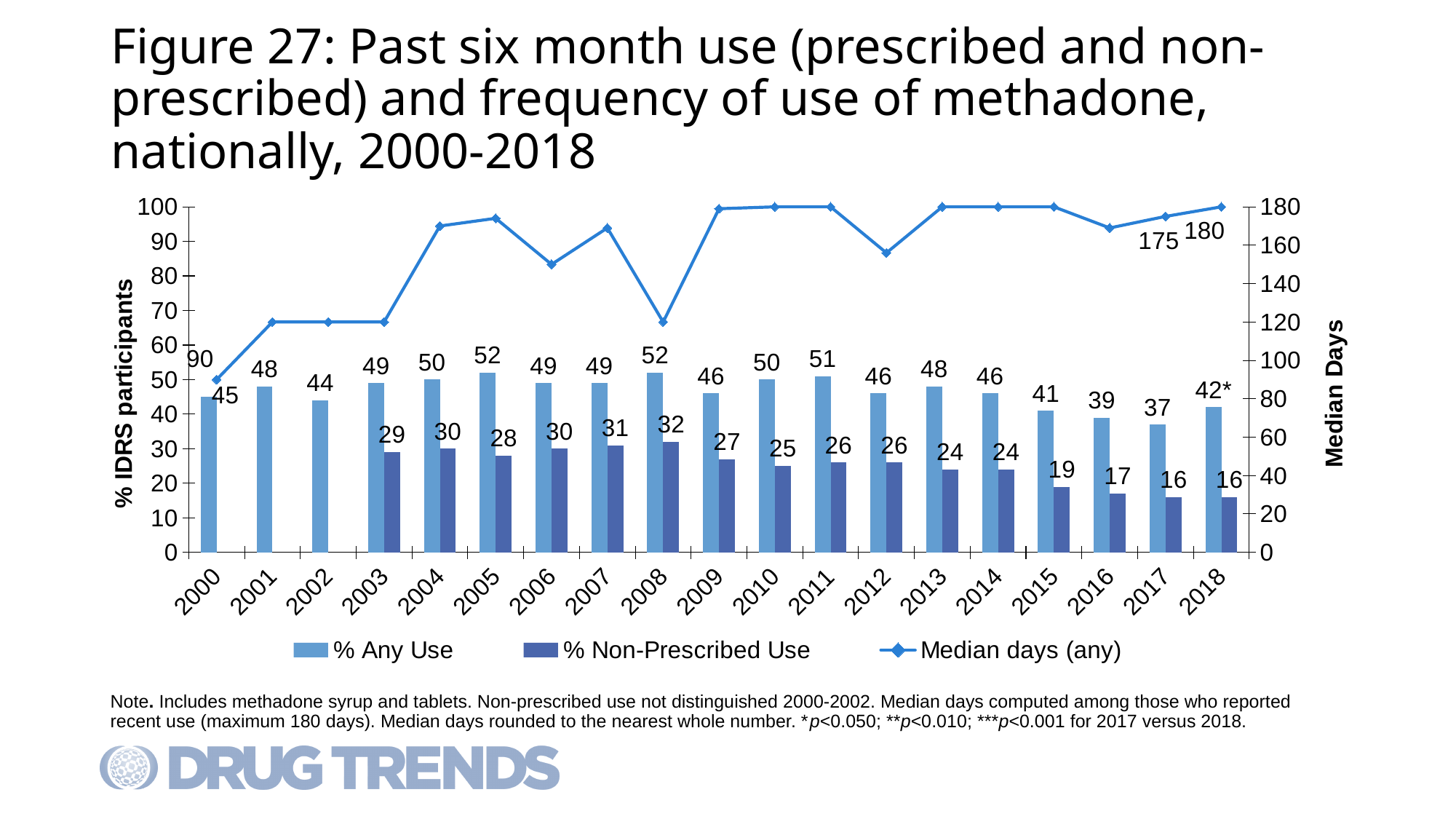
What kind of chart is this? Combined bar and line chart What is the % Any Use value for 2005? 52 What is the % Non-Prescribed Use value for 2008? 32 What is the Median days (any) value labelled for 2017? 175 Does % Non-Prescribed Use rise or fall from 2013 to 2018? fall Is the Median days (any) value for 2008 greater or less than 140? less In which year is % Any Use lowest? 2017 How many years are shown on the x axis? 19 In which year is % Non-Prescribed Use highest? 2008 What is the difference between % Any Use and % Non-Prescribed Use in 2018? 26 How many series does the legend list? 3 Which year has the higher % Any Use, 2001 or 2002? 2001